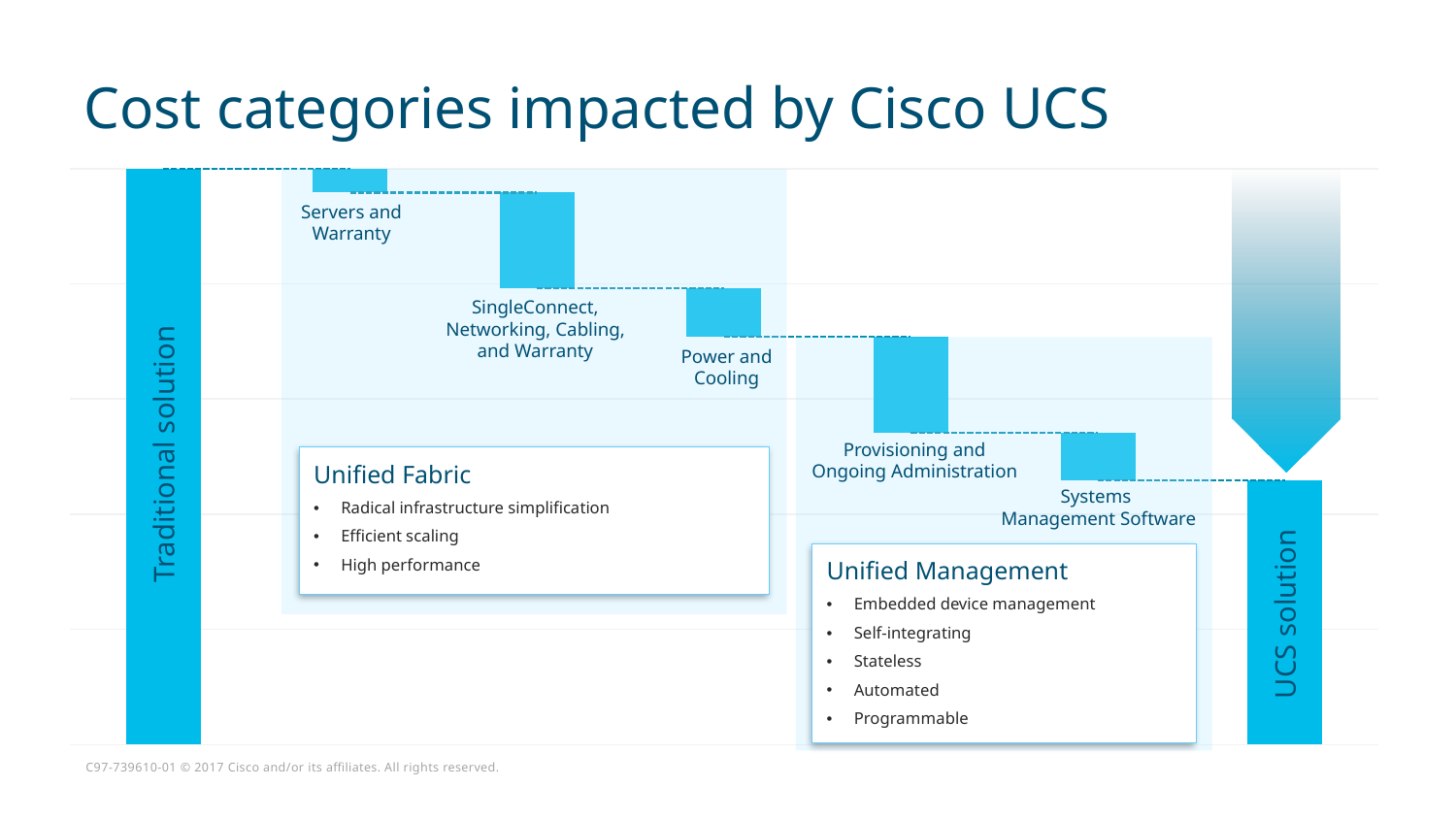
What is the label of the leftmost bar in the chart? Traditional solution Which reduction bar is larger, SingleConnect, Networking, Cabling, and Warranty or Power and Cooling? SingleConnect, Networking, Cabling, and Warranty Which two cost categories are grouped under the Unified Management box? Provisioning and Ongoing Administration; Systems Management Software Which is larger, the Traditional solution bar or the UCS solution bar? Traditional solution What is the title of the chart on the slide? Cost categories impacted by Cisco UCS What is the label of the rightmost bar in the chart? UCS solution Which reduction bar is larger, Provisioning and Ongoing Administration or Systems Management Software? Provisioning and Ongoing Administration What kind of chart is shown on the slide? waterfall chart How many cost categories are shown as reductions between the Traditional solution bar and the UCS solution bar? 5 Do the cumulative cost levels rise or fall moving from left to right across the chart? fall